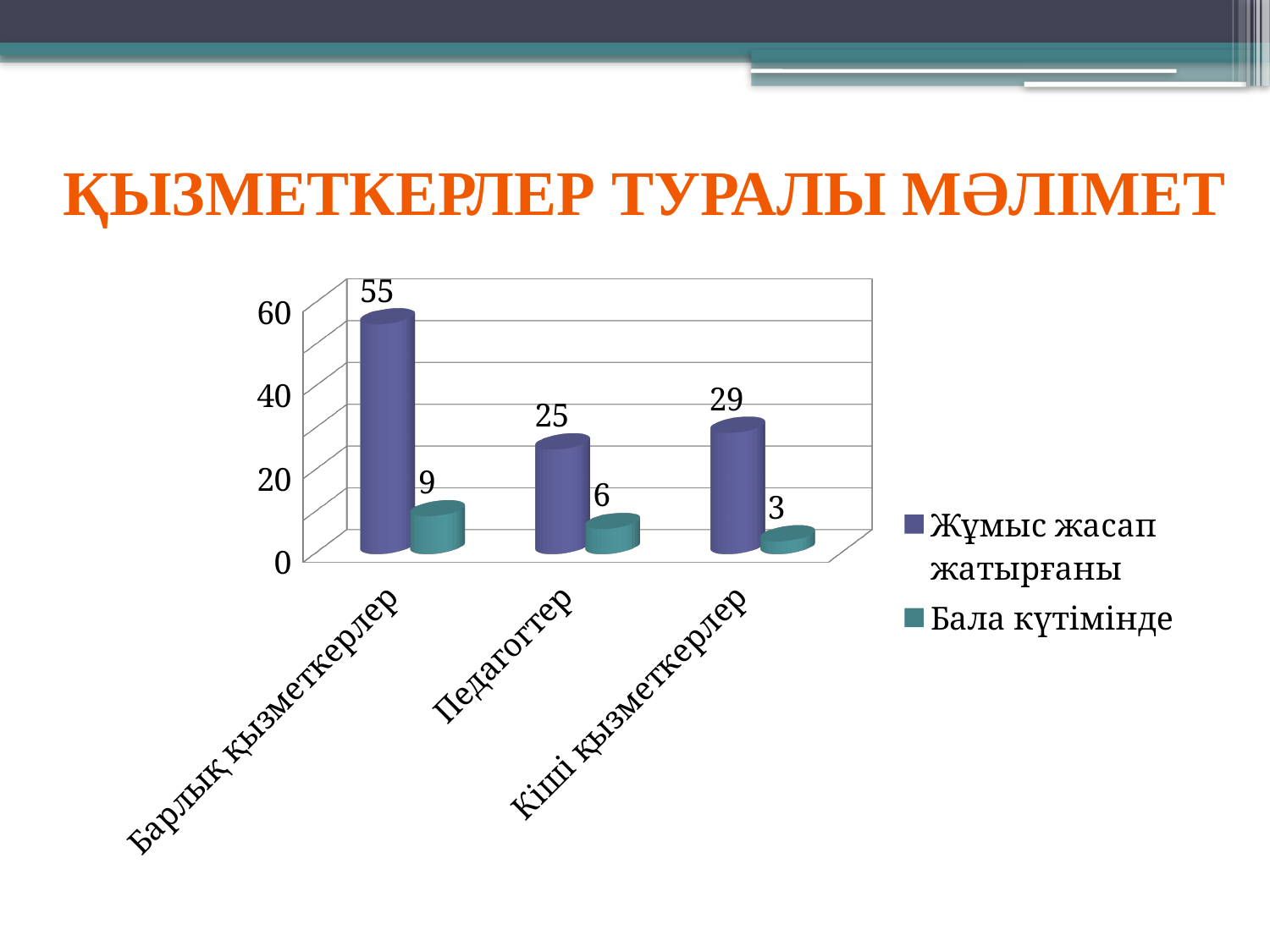
What is the value for Кіші қызметкерлер in the Жұмыс жасап жатырғаны series? 29 How many series does the legend list? 2 What is the difference between the Жұмыс жасап жатырғаны values for Кіші қызметкерлер and Педагогтер? 4 What is the title of the slide? ҚЫЗМЕТКЕРЛЕР ТУРАЛЫ МӘЛІМЕТ Which category has the highest value in the Жұмыс жасап жатырғаны series? Барлық қызметкерлер Is the Жұмыс жасап жатырғаны value for Педагогтер greater or less than 40? less What is the value for Педагогтер in the Бала күтімінде series? 6 What is the value for Барлық қызметкерлер in the Жұмыс жасап жатырғаны series? 55 Which category has the lowest value in the Бала күтімінде series? Кіші қызметкерлер Which is larger: the Бала күтімінде value for Барлық қызметкерлер or for Педагогтер? Барлық қызметкерлер How many categories are shown on the x axis? 3 What kind of chart is shown on the slide? bar chart